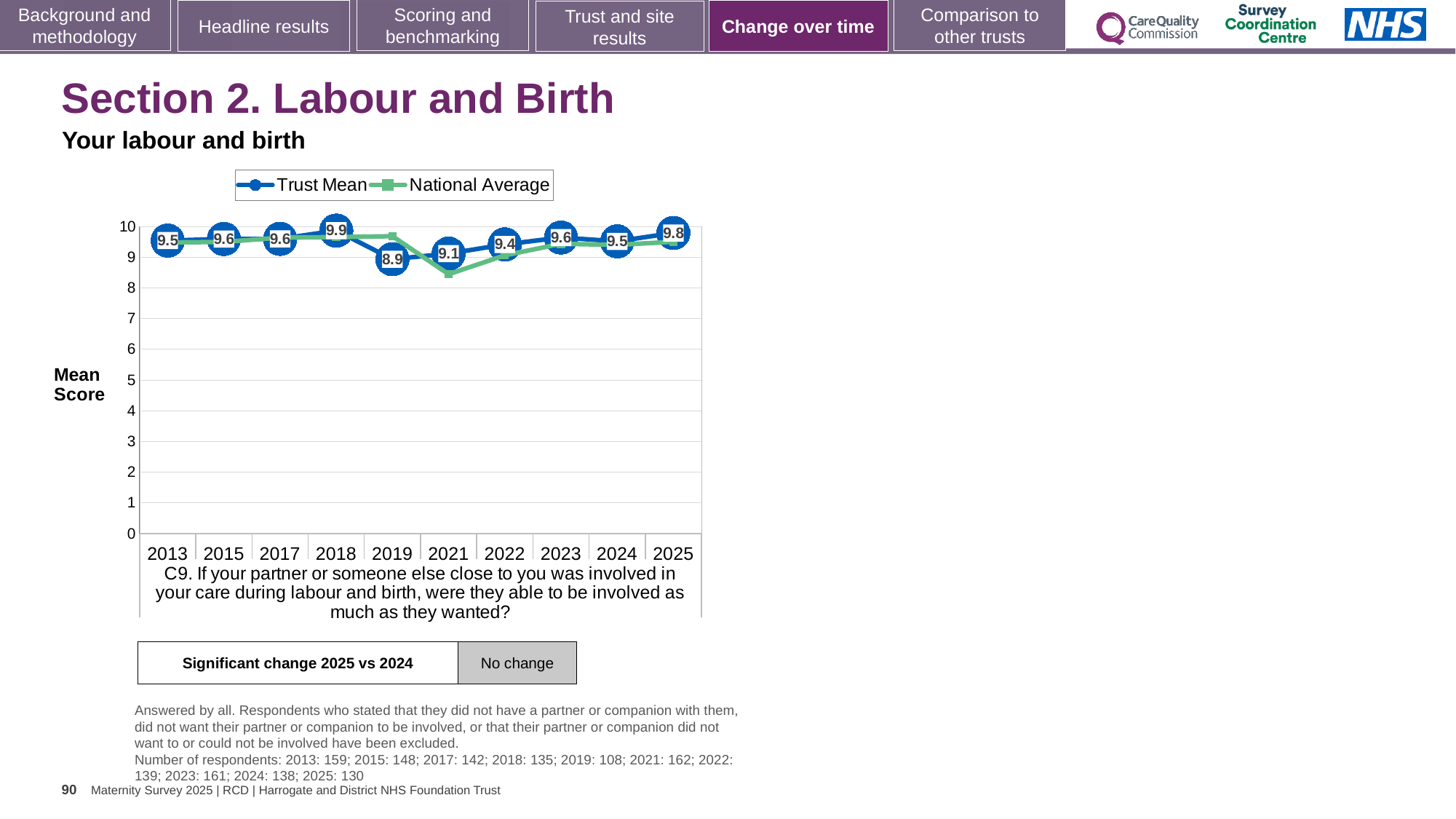
Is the National Average value for 2021 greater or less than 9? less How many years are shown on the x axis? 10 Does the Trust Mean rise or fall from 2019 to 2023? rise In which year is the Trust Mean lowest? 2019 What is the Trust Mean value for 2021? 9.1 Which is larger, the Trust Mean in 2022 or in 2023? 2023 What is the difference between the Trust Mean in 2018 and in 2019? 1.0 How many series does the legend list? 2 What is the Trust Mean value for 2018? 9.9 What is the Trust Mean value for 2025? 9.8 What kind of chart is shown on the slide? line chart In which year is the Trust Mean highest? 2018